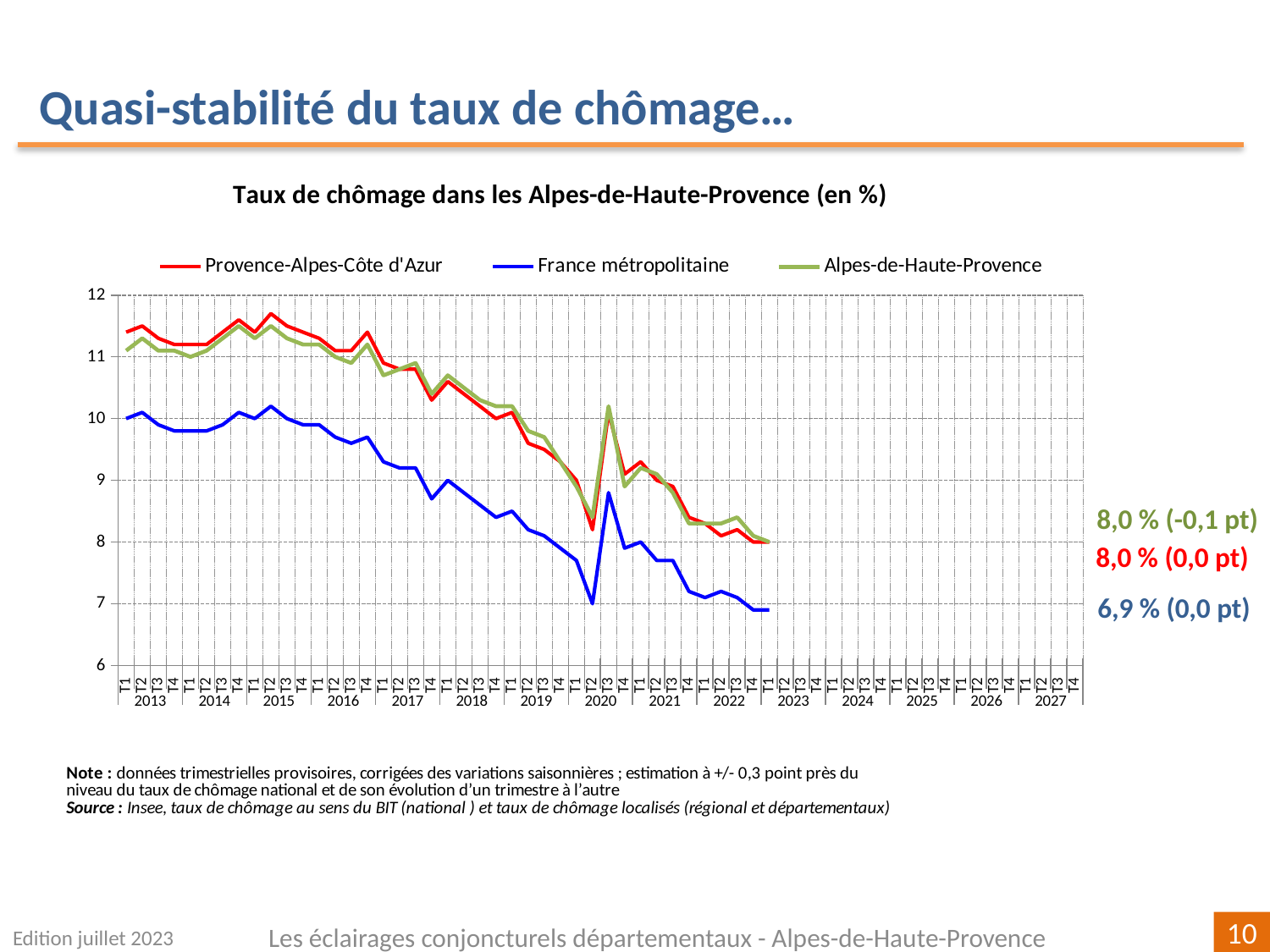
What is the title of the chart? Taux de chômage dans les Alpes-de-Haute-Provence (en %) Is the value for Provence-Alpes-Côte d'Azur in T1 2013 greater or less than 11? greater What kind of chart is shown on the slide? line chart Which series has the lowest values across the whole period? France métropolitaine Is the value for France métropolitaine in T2 2020 greater or less than 8? less What is the latest unemployment rate shown for France métropolitaine? 6,9 % What is the difference between the latest Alpes-de-Haute-Provence rate and the latest France métropolitaine rate? 1,1 points What is the latest unemployment rate shown for Provence-Alpes-Côte d'Azur? 8,0 % What is the latest unemployment rate shown for Alpes-de-Haute-Provence? 8,0 % How many series does the legend list? 3 Overall, do the unemployment rates rise or fall from 2013 to 2023? fall By how many points did the Alpes-de-Haute-Provence rate change in the latest quarter, according to the label? -0,1 pt